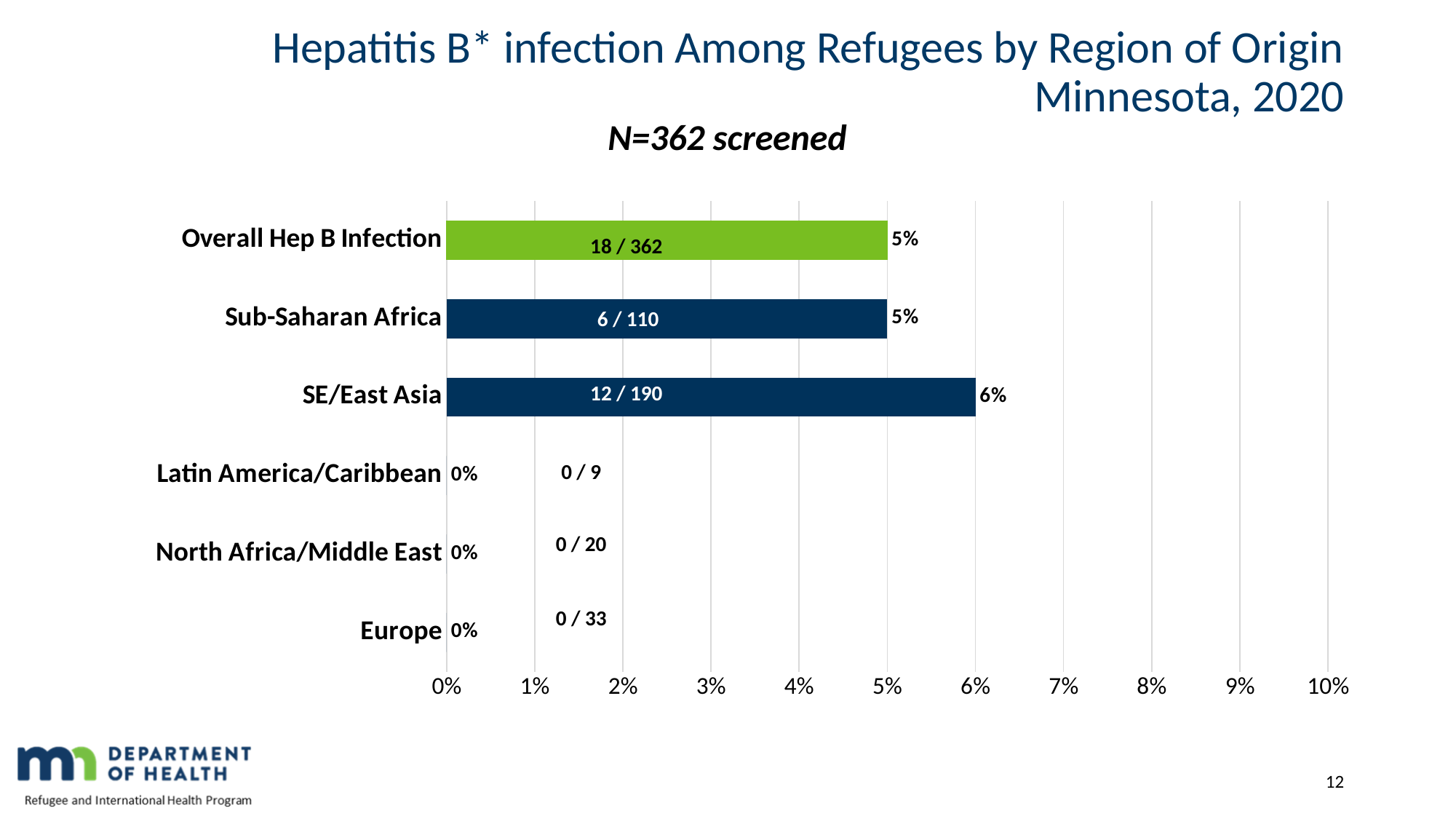
What is the difference in infection percentage between SE/East Asia and Sub-Saharan Africa? 1% What colour is the Overall Hep B Infection bar? Green What kind of chart is shown on the slide? Bar chart What is the Hepatitis B infection percentage for Sub-Saharan Africa? 5% What is the Hepatitis B infection percentage for SE/East Asia? 6% What fraction is shown for North Africa/Middle East? 0 / 20 How many categories are shown on the chart? 6 How many refugees were screened according to the chart subtitle? 362 Which has a higher infection percentage, SE/East Asia or Latin America/Caribbean? SE/East Asia What fraction is shown on the Overall Hep B Infection bar? 18 / 362 Which region of origin has the highest Hepatitis B infection percentage? SE/East Asia What fraction is shown for Europe? 0 / 33